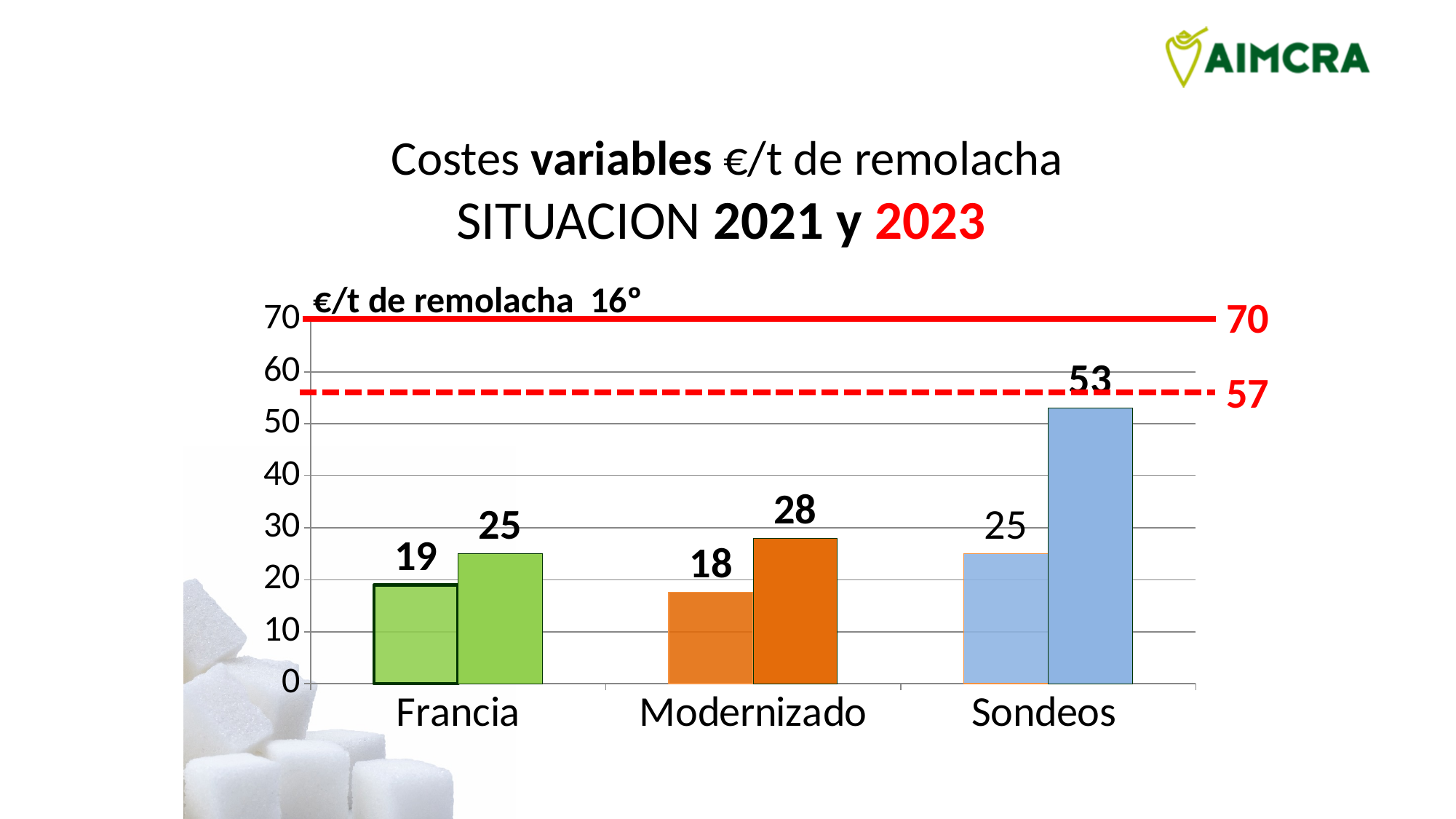
Is the value of the right bar for Sondeos greater or less than 50? greater What is the value of the left (first) bar for Francia? 19 What value is labelled on the solid red horizontal line at the top of the chart? 70 What type of chart is shown on the slide? bar chart What is the difference between the two bars for Sondeos? 28 Which category has the lowest bar in the chart? Modernizado Which category has the highest bar in the chart? Sondeos What is the value of the right (second) bar for Francia? 25 What is the value of the right (second) bar for Sondeos? 53 What is the value of the right (second) bar for Modernizado? 28 How many categories are shown on the x axis of the chart? 3 Which is larger: the right bar for Modernizado or the right bar for Francia? Modernizado